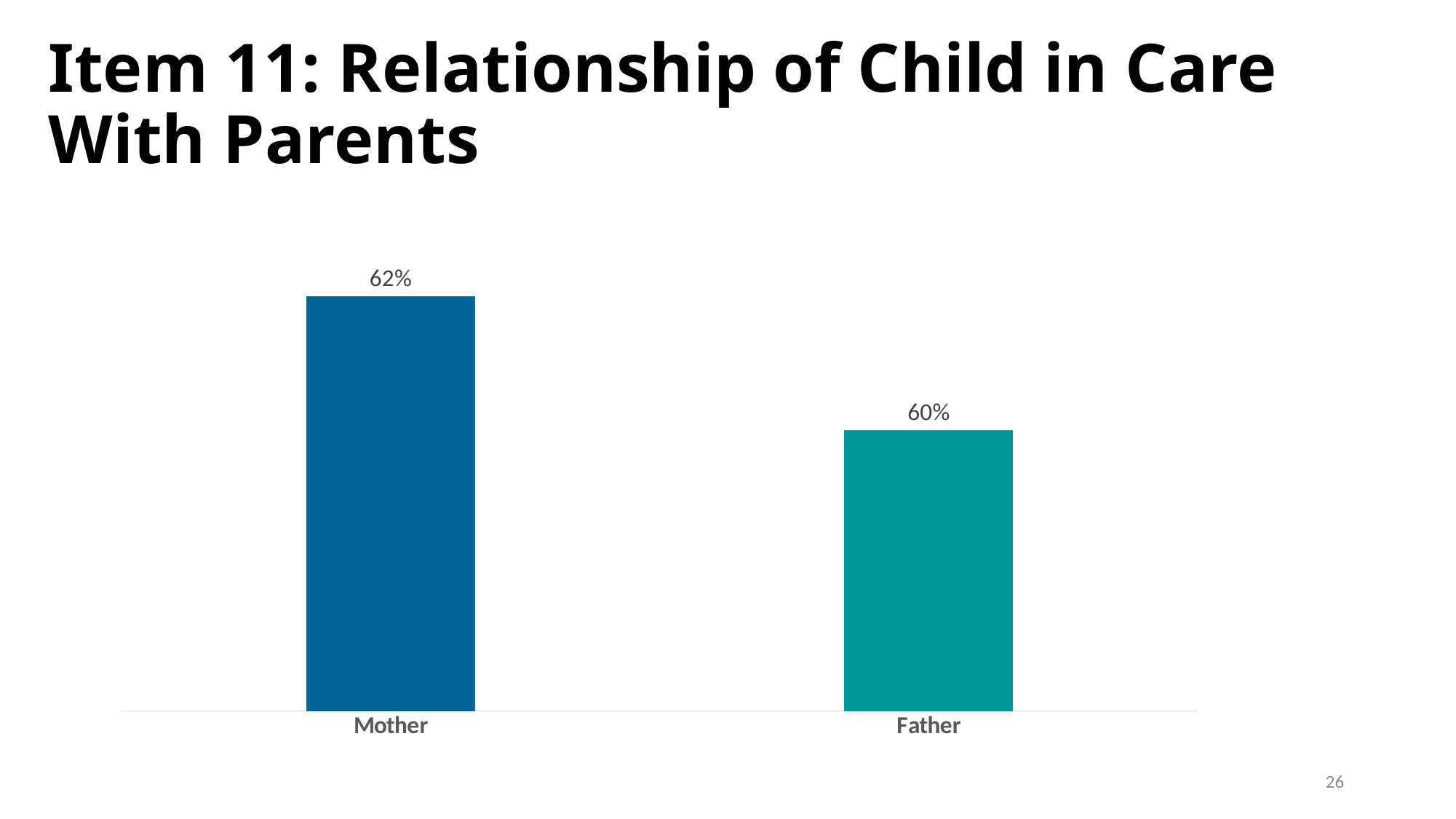
What colour is the bar for Father? Teal What kind of chart is shown on the slide? Bar chart What is the difference between the values for Mother and Father? 2% What is the title of the slide? Item 11: Relationship of Child in Care With Parents Which category has the lowest value? Father How many categories are shown in the chart? 2 Which is larger, the value for Mother or the value for Father? Mother What is the value for Father? 60% What is the value for Mother? 62% Which category has the highest value? Mother